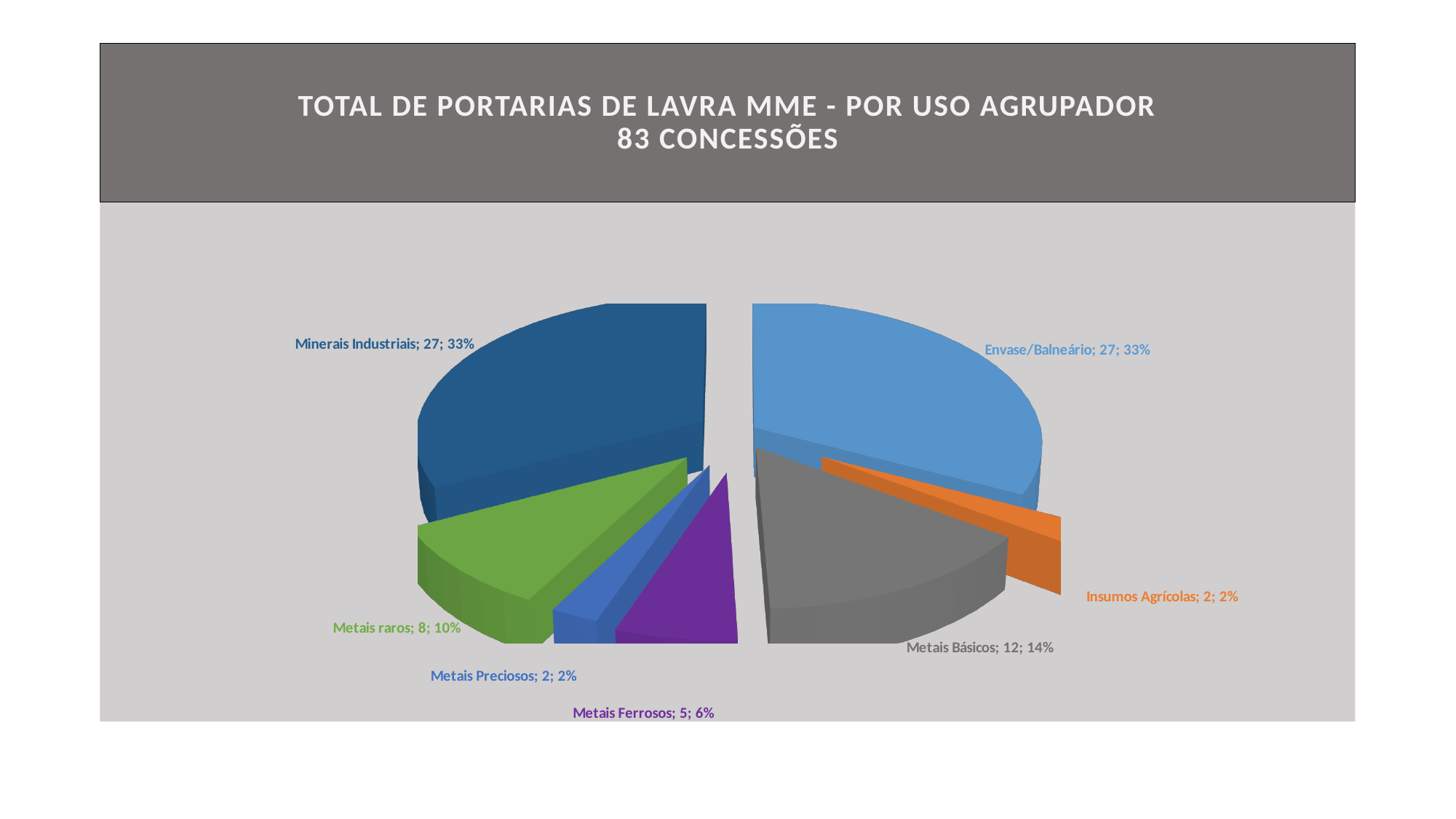
What is the difference between the values for Metais Básicos and Metais raros? 4 What colour is the Insumos Agrícolas slice? Orange How many slices does the pie chart have? 7 What percentage share does Envase/Balneário have? 33% What is the value for Metais Básicos? 12 What percentage share does Metais raros have? 10% What is the difference between the values for Minerais Industriais and Metais Ferrosos? 22 What is the value for Metais Ferrosos? 5 What is the title of the chart? TOTAL DE PORTARIAS DE LAVRA MME - POR USO AGRUPADOR 83 CONCESSÕES Which category has the largest value, Metais Básicos or Metais raros? Metais Básicos Which category has the lowest value, Metais Ferrosos or Insumos Agrícolas? Insumos Agrícolas What kind of chart is shown on the slide? Pie chart